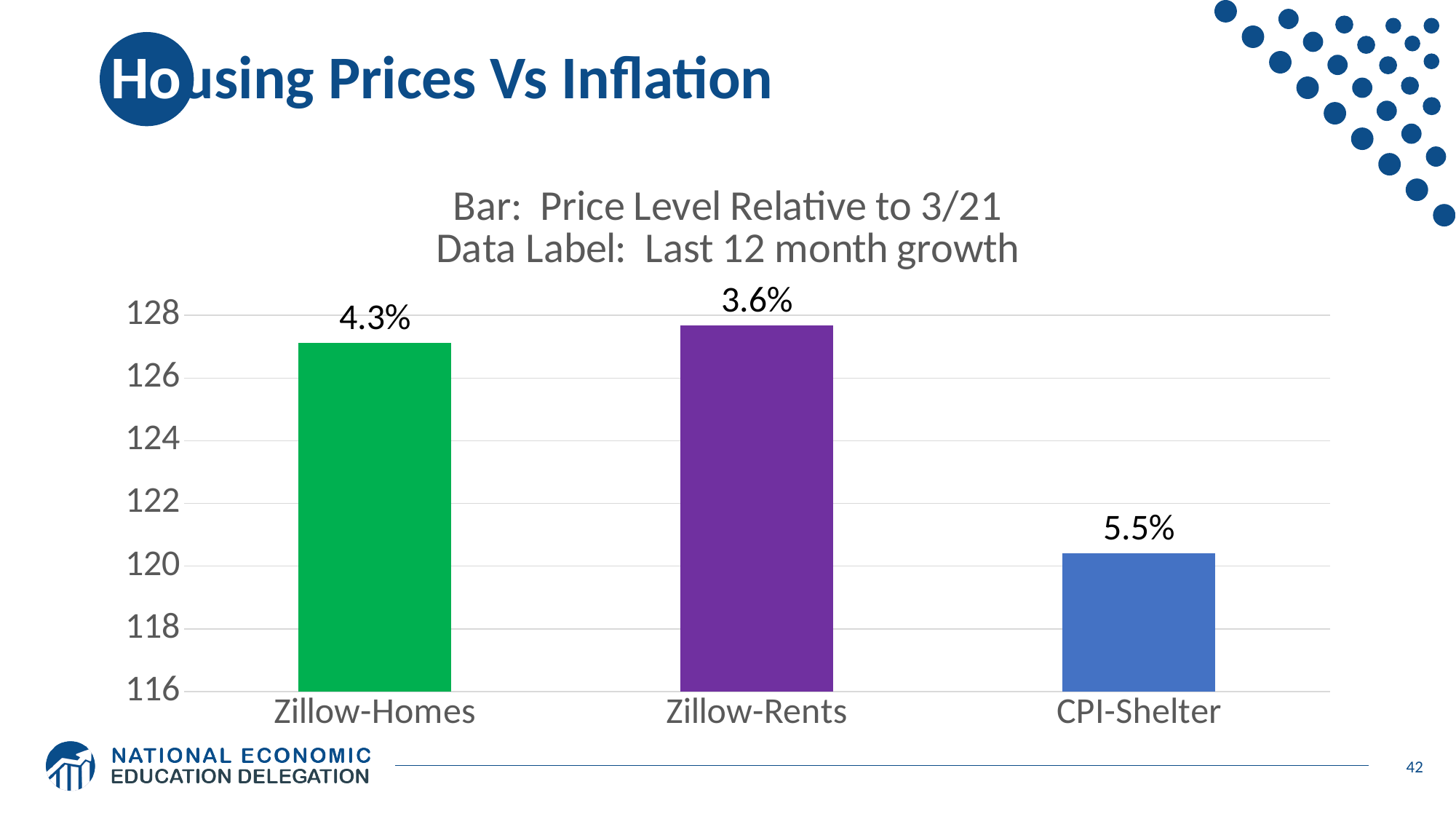
What is the last 12 month growth data label shown for CPI-Shelter? 5.5% What is the last 12 month growth data label shown for Zillow-Homes? 4.3% Which has the larger growth data label, Zillow-Homes or Zillow-Rents? Zillow-Homes Which category has the lowest bar (price level relative to 3/21)? CPI-Shelter How many categories are shown in the chart? 3 What is the last 12 month growth data label shown for Zillow-Rents? 3.6% Which category has the lowest last 12 month growth data label? Zillow-Rents What is the difference between the growth data labels for CPI-Shelter and Zillow-Rents? 1.9 percentage points Is the bar value for CPI-Shelter greater or less than 122? less Which category has the highest last 12 month growth data label? CPI-Shelter What type of chart is shown on the slide? Bar chart Is the bar value for Zillow-Homes greater or less than 126? greater